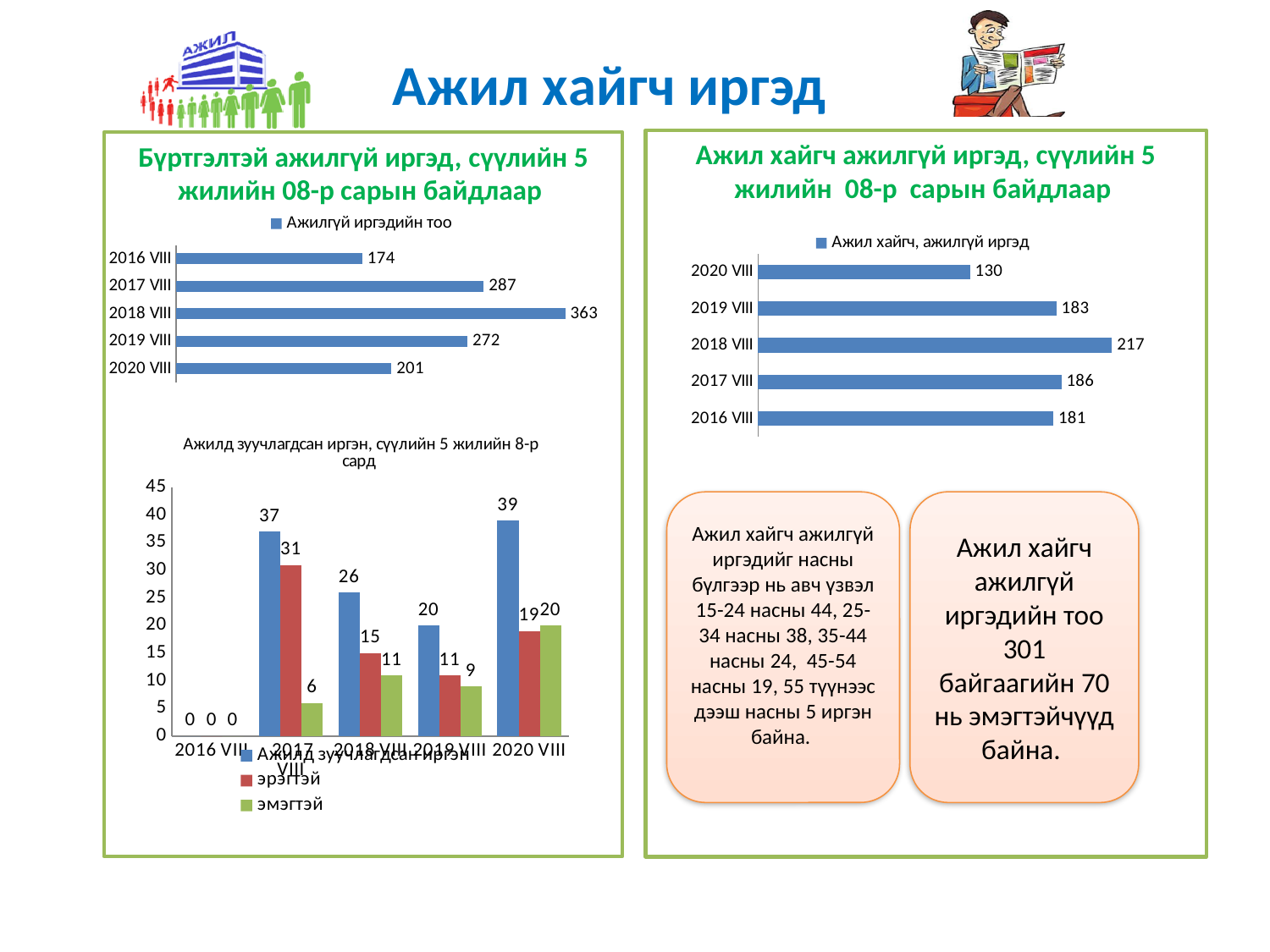
In the bottom-left chart (Ажилд зуучлагдсан иргэн), how many series does the legend list? 3 In the right-hand chart (Ажил хайгч, ажилгүй иргэд), which is larger, the value for 2017 VIII or 2019 VIII? 2017 VIII In the right-hand chart (Ажил хайгч, ажилгүй иргэд), what is the value for 2020 VIII? 130 In the bottom-left chart (Ажилд зуучлагдсан иргэн), which year has the highest value for Ажилд зуучлагдсан иргэн? 2020 VIII In the top-left chart (Ажилгүй иргэдийн тоо), what is the value for 2018 VIII? 363 In the bottom-left chart (Ажилд зуучлагдсан иргэн), what is the difference between эрэгтэй and эмэгтэй for 2017 VIII? 25 What kind of chart is the right-hand chart (Ажил хайгч, ажилгүй иргэд)? Bar chart In the top-left chart (Ажилгүй иргэдийн тоо), what is the difference between the values for 2017 VIII and 2020 VIII? 86 In the right-hand chart (Ажил хайгч, ажилгүй иргэд), which year has the highest value? 2018 VIII In the top-left chart (Ажилгүй иргэдийн тоо), how many years are shown? 5 In the top-left chart (Ажилгүй иргэдийн тоо), which year has the lowest value? 2016 VIII In the bottom-left chart (Ажилд зуучлагдсан иргэн), what is the value of эмэгтэй for 2020 VIII? 20